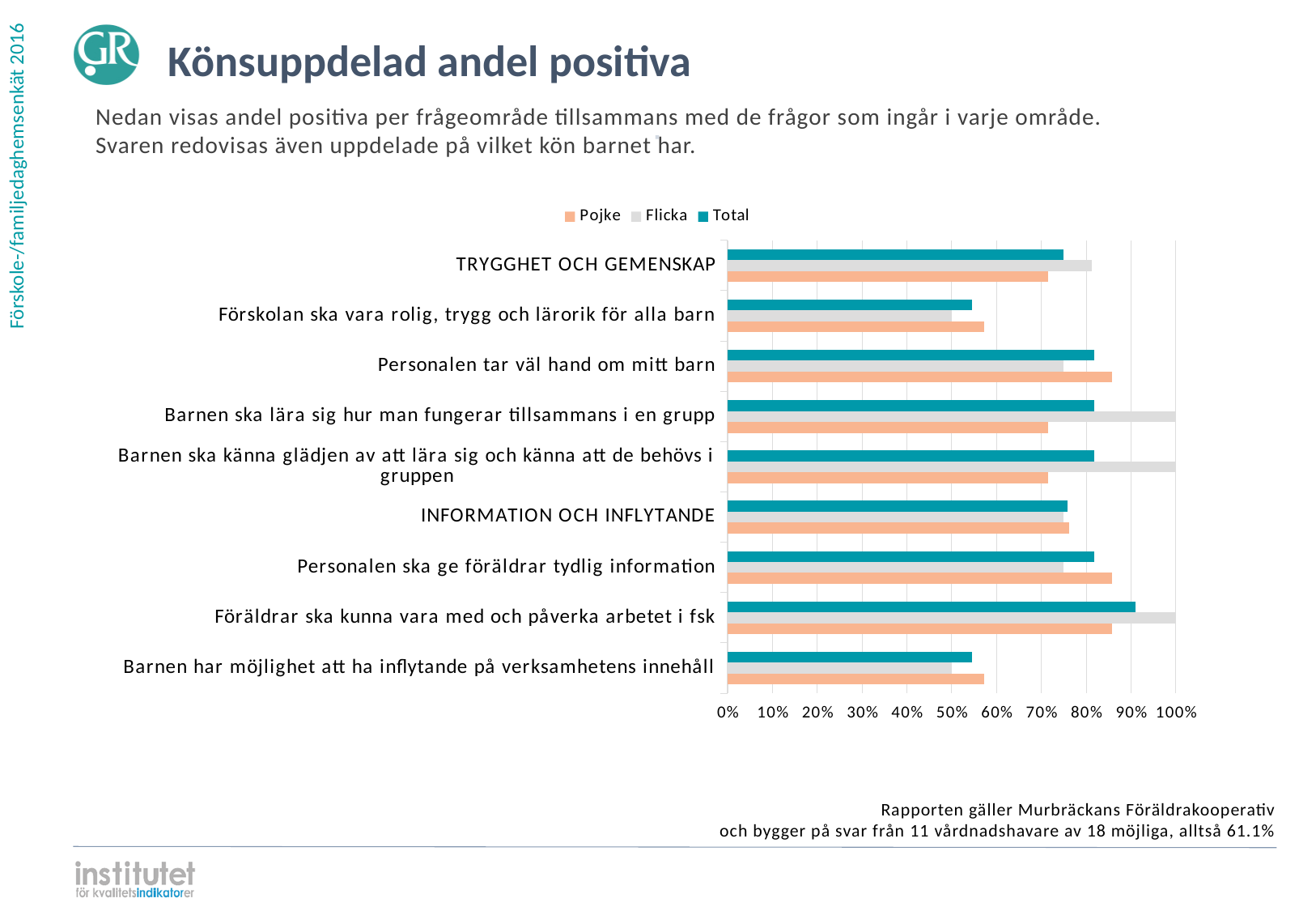
Is the Pojke value for "Personalen tar väl hand om mitt barn" greater or less than 80%? greater Which category has the highest Total value? Föräldrar ska kunna vara med och påverka arbetet i fsk What is the Flicka value for "Barnen ska lära sig hur man fungerar tillsammans i en grupp"? 100% What is the title of the slide containing the chart? Könsuppdelad andel positiva Is the Total value for "Förskolan ska vara rolig, trygg och lärorik för alla barn" greater or less than 60%? less Which series is shown in orange in the legend? Pojke What kind of chart is shown on the slide? Bar chart For "Barnen ska lära sig hur man fungerar tillsammans i en grupp", which is larger: the Pojke value or the Flicka value? Flicka Is the Pojke value for "TRYGGHET OCH GEMENSKAP" greater or less than 80%? less How many categories are plotted on the y axis of the chart? 9 How many series does the legend list? 3 What is the Flicka value for "Föräldrar ska kunna vara med och påverka arbetet i fsk"? 100%